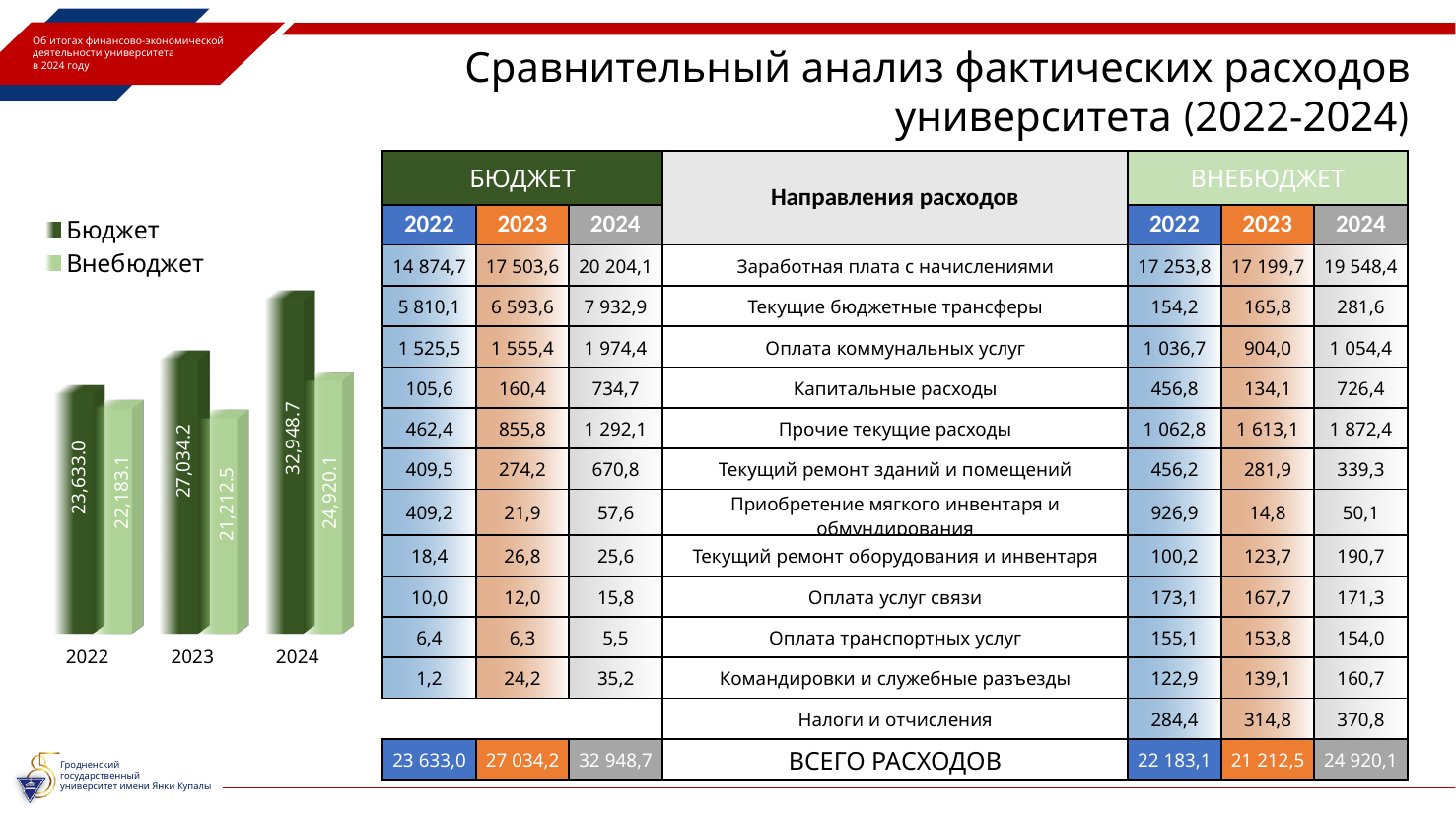
How many years (categories) are shown on the x axis of the chart? 3 What type of chart is shown on the left of the slide? bar chart What is the value of Бюджет for 2023 in the chart? 27,034.2 What is the value of Внебюджет for 2023 in the chart? 21,212.5 In which year is the Внебюджет value lowest in the chart? 2023 Which is larger in 2022 in the chart: Бюджет or Внебюджет? Бюджет What are the two series named in the chart legend? Бюджет and Внебюджет What is the difference between the Бюджет and Внебюджет values for 2024 in the chart? 8,028.6 What is the value of Бюджет for 2024 in the chart? 32,948.7 How many series does the chart legend list? 2 In which year is the Бюджет value highest in the chart? 2024 What is the value of Внебюджет for 2022 in the chart? 22,183.1